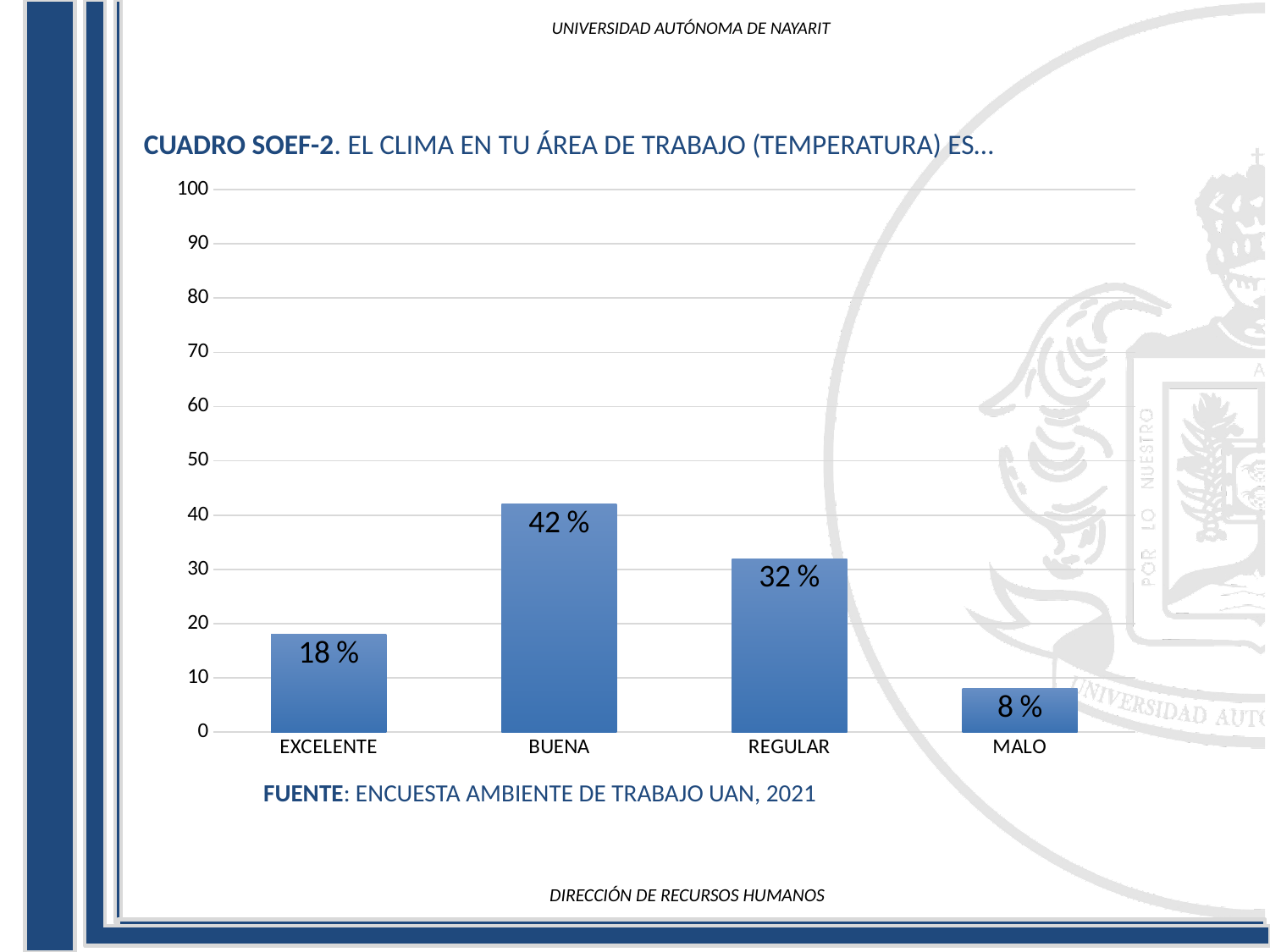
Which category has the lowest value? MALO Is the value for BUENA greater or less than 50? less How many categories are shown on the x axis? 4 Which is larger, the value for EXCELENTE or the value for REGULAR? REGULAR What is the difference between the values for BUENA and REGULAR? 10 % What is the value for MALO? 8 % What is the value for EXCELENTE? 18 % Which category has the highest value? BUENA What is the source cited below the chart? ENCUESTA AMBIENTE DE TRABAJO UAN, 2021 What is the value for BUENA? 42 % What kind of chart is shown on the slide? bar chart What is the value for REGULAR? 32 %